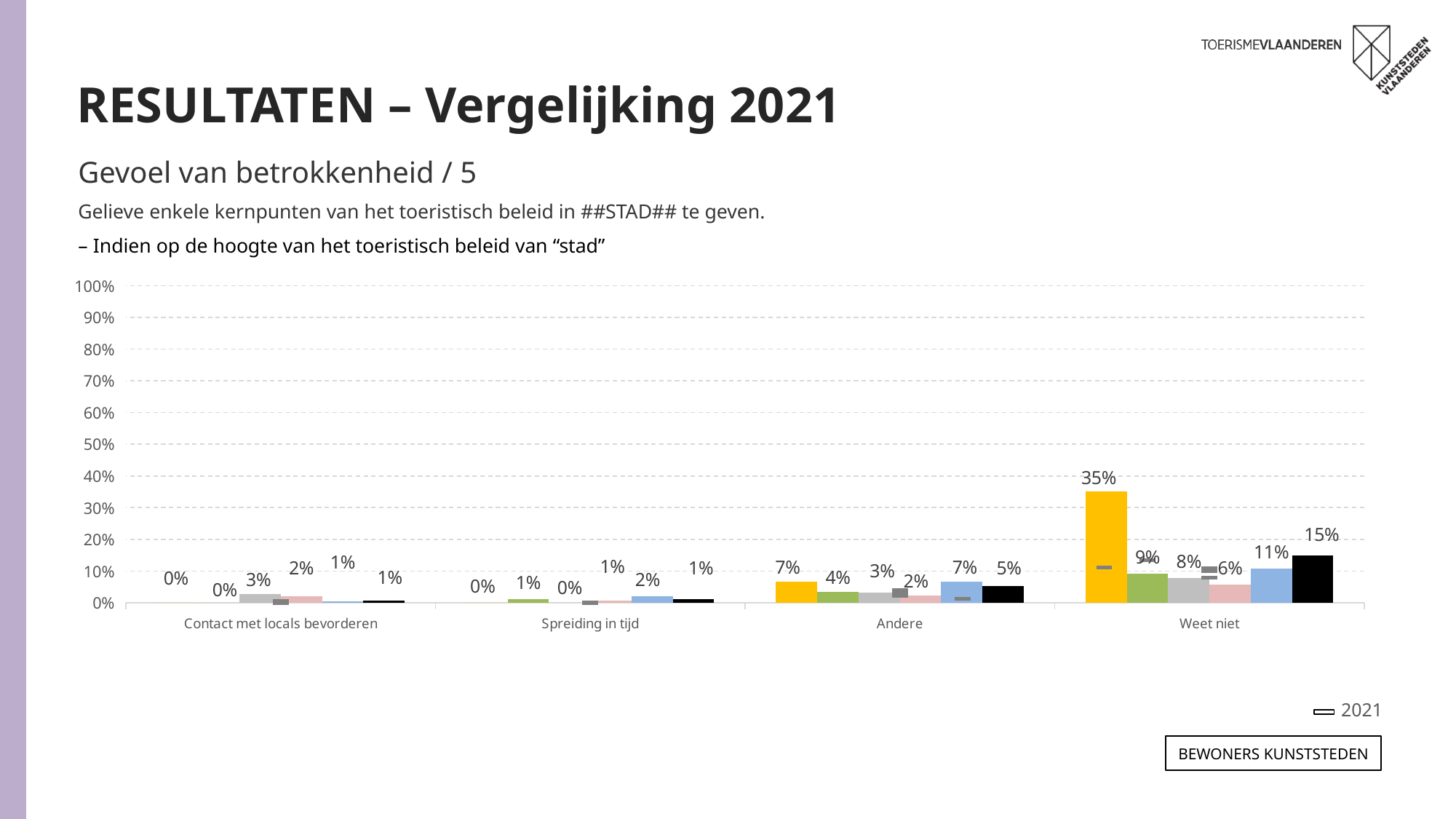
What is the value of the yellow bar for 'Weet niet'? 35% What is the value of the yellow bar for 'Andere'? 7% Is the value of the yellow bar for 'Weet niet' greater or less than 30%? greater Which category contains the highest bar in the chart? Weet niet How many entries does the chart's legend list? 1 What kind of chart is shown on the slide? bar chart What is the difference between the yellow bar (35%) and the black bar (15%) for 'Weet niet'? 20 percentage points What is the value of the blue bar for 'Weet niet'? 11% What label is shown in the chart's legend? 2021 How many categories are shown on the x axis of the chart? 4 Which is larger: the yellow bar for 'Andere' or the yellow bar for 'Weet niet'? the yellow bar for 'Weet niet' What is the value of the black bar for 'Weet niet'? 15%